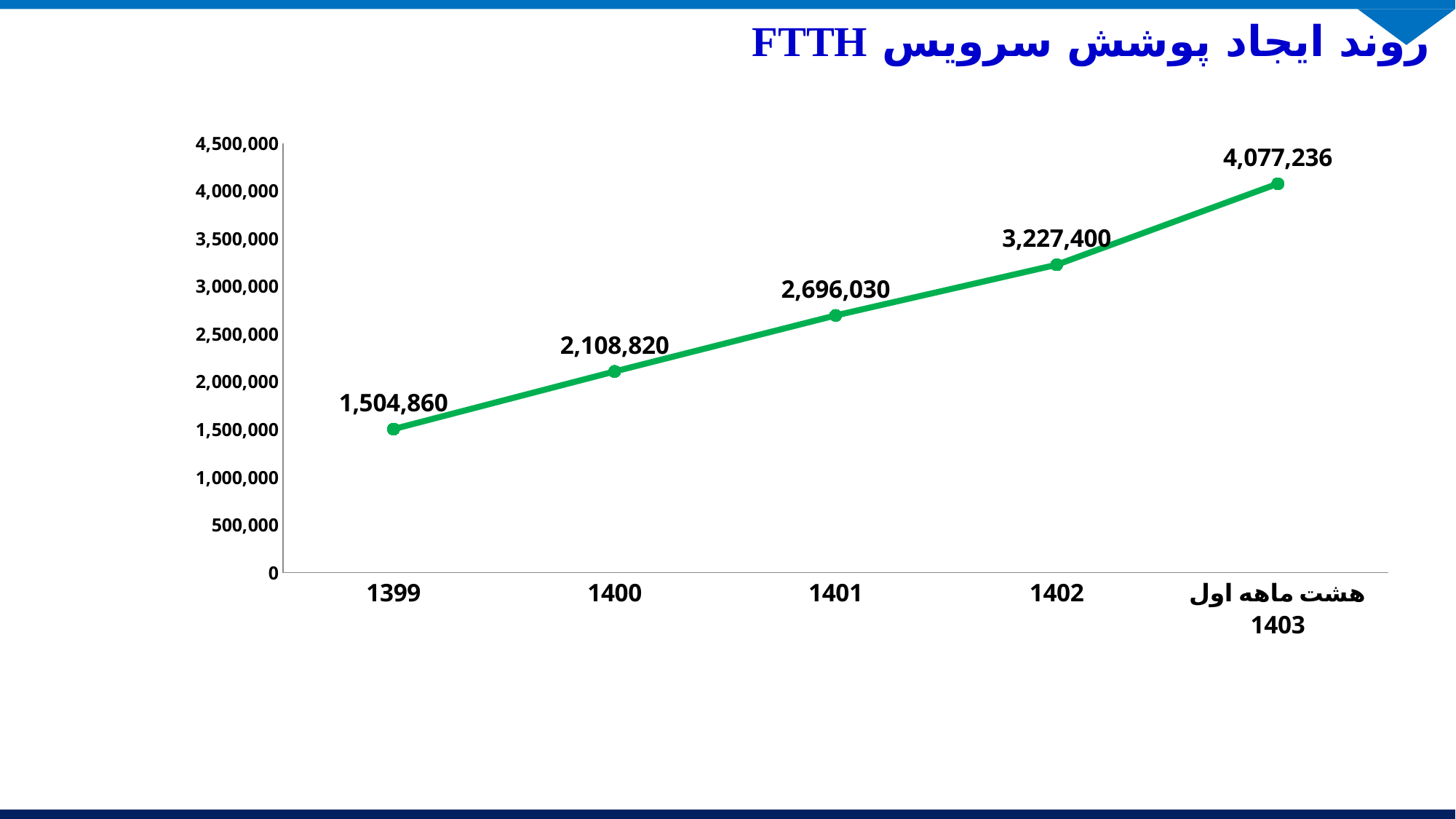
What is the value plotted for 1401? 2,696,030 What is the difference between the values for 1402 and 1401? 531,370 Which is larger, the value for 1400 or the value for 1402? 1402 Which category has the highest value? هشت ماهه اول 1403 Do the values rise or fall from 1399 to هشت ماهه اول 1403? rise What kind of chart is shown on the slide? line chart How many data points are plotted on the line? 5 What is the difference between the values for هشت ماهه اول 1403 and 1402? 849,836 What is the value plotted for 1399? 1,504,860 Which category has the lowest value? 1399 What is the value plotted for the first eight months of 1403 (هشت ماهه اول 1403)? 4,077,236 Is the value for 1400 greater or less than 2,000,000? greater